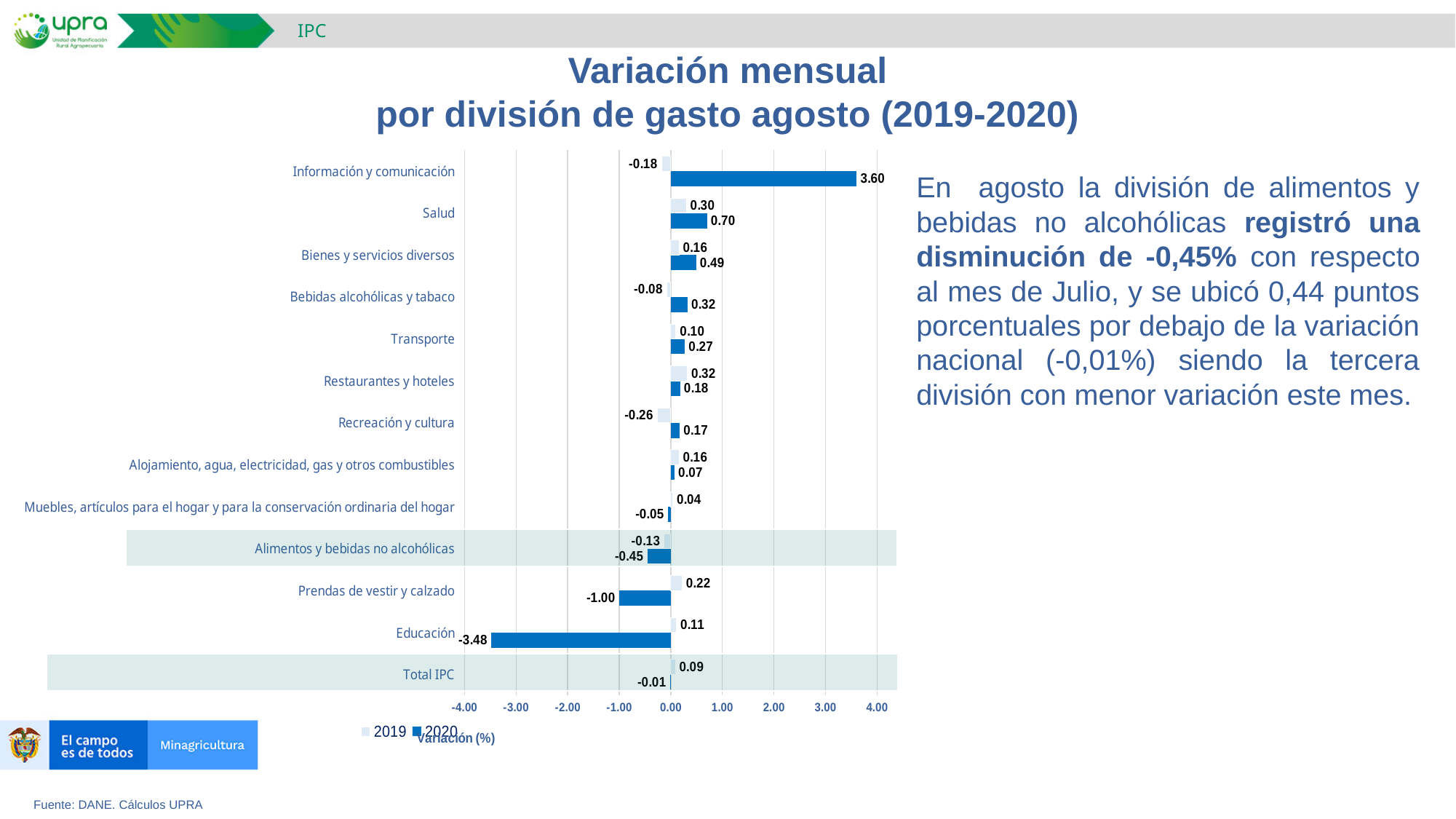
What is the 2020 value for Alimentos y bebidas no alcohólicas? -0.45 What kind of chart is shown on the slide? Bar chart How many categories are shown on the chart? 13 What is the 2019 value for Recreación y cultura? -0.26 What is the difference between the 2020 and 2019 values for Salud? 0.40 What is the 2020 value for Información y comunicación? 3.60 Which category has the highest 2020 value? Información y comunicación Is the 2020 value for Prendas de vestir y calzado greater or less than -2.00? greater Which category has the lowest 2020 value? Educación What is the 2020 value for Educación? -3.48 For Restaurantes y hoteles, which series has the larger value, 2019 or 2020? 2019 How many series does the legend list? 2